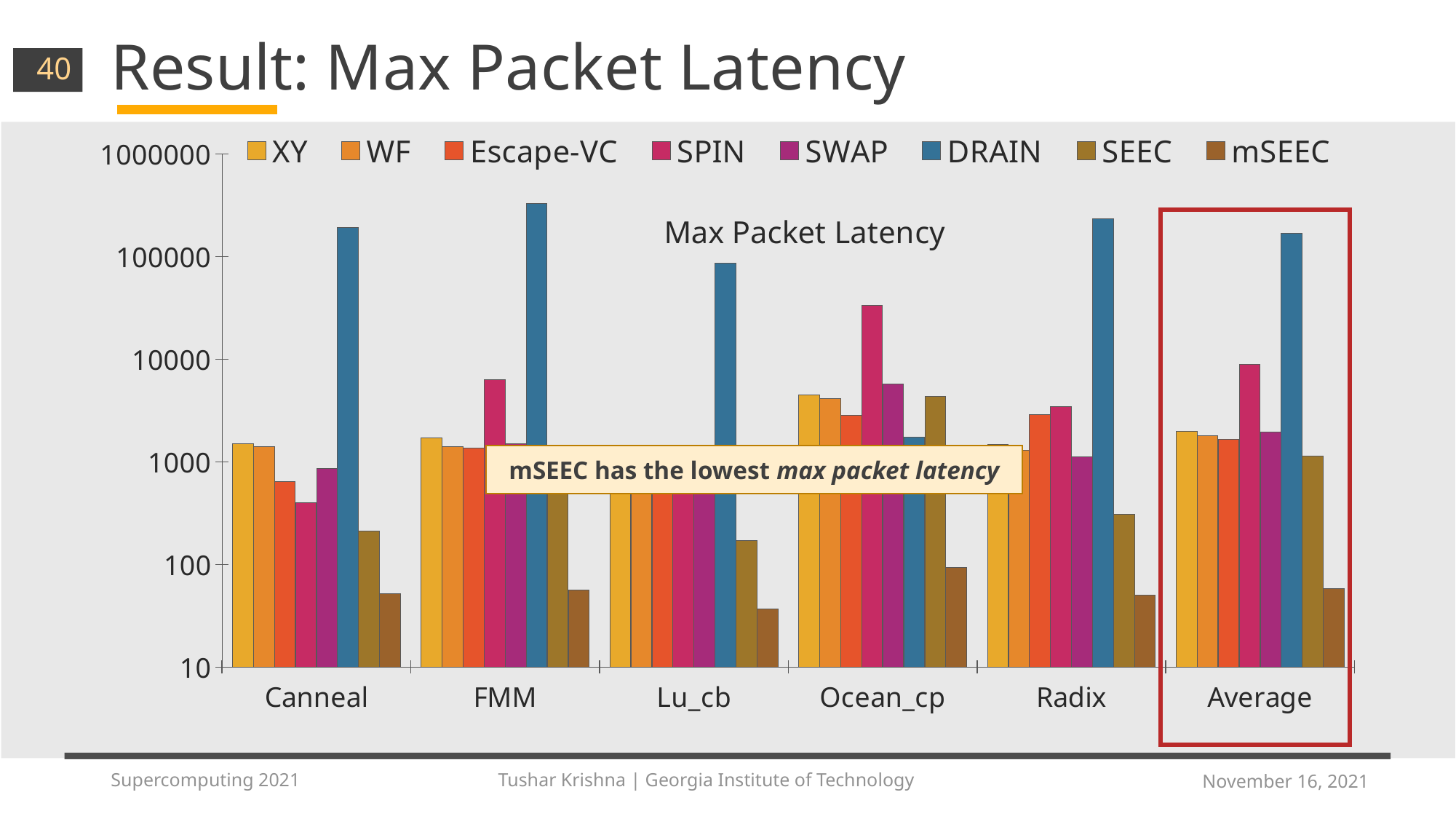
Is the mSEEC value for Canneal greater or less than 100? less Is the SPIN value for Ocean_cp greater or less than 10000? greater How many series does the legend list? 8 How many categories are shown along the x axis? 6 For Canneal, which is larger: the SPIN value or the SWAP value? SWAP Is the DRAIN value for FMM greater or less than 100000? greater Which series has the highest max packet latency for Canneal? DRAIN Which series has the highest max packet latency for Ocean_cp? SPIN For Radix, which is larger: the SPIN value or the SWAP value? SPIN Which series has the lowest max packet latency for Average? mSEEC What kind of chart is shown on the slide? bar chart Which category on the x axis is highlighted with a red box? Average